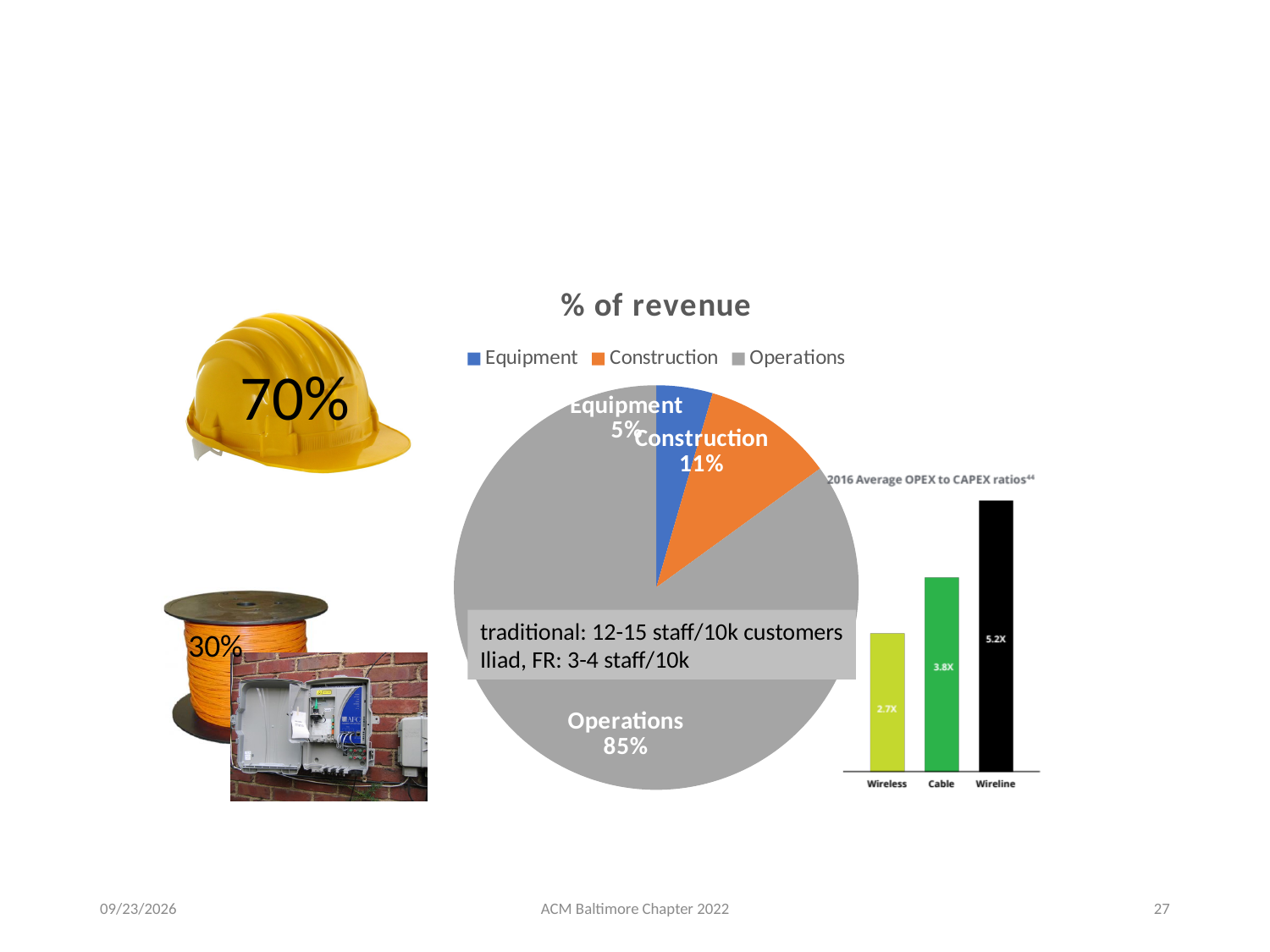
In the "% of revenue" pie chart, what share of revenue is Operations? 85% What type of chart is the "2016 Average OPEX to CAPEX ratios" chart? Bar chart In the "% of revenue" pie chart, which category has the smallest slice? Equipment In the "% of revenue" pie chart, what is the difference between the Construction and Equipment shares? 6% In the "% of revenue" pie chart, what share of revenue is Equipment? 5% In the "2016 Average OPEX to CAPEX ratios" chart, which category has the lowest ratio? Wireless What type of chart is the "% of revenue" chart? Pie chart In the "2016 Average OPEX to CAPEX ratios" chart, what is the value for Wireline? 5.2X In the "2016 Average OPEX to CAPEX ratios" chart, what is the value for Cable? 3.8X In the "% of revenue" pie chart, how many categories does the legend list? 3 In the "% of revenue" pie chart, which category has the largest slice? Operations In the "% of revenue" pie chart, what share of revenue is Construction? 11%